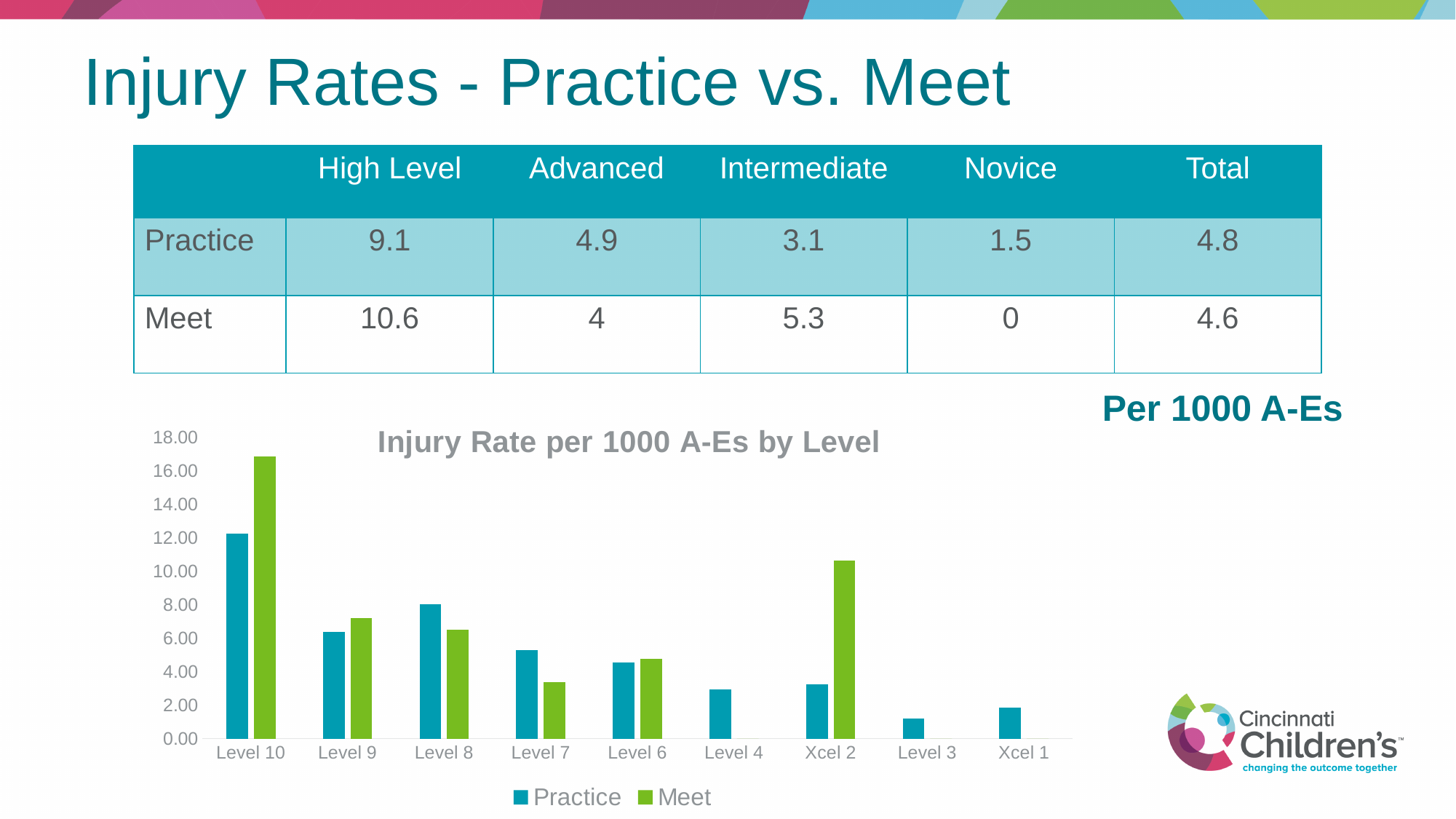
How many series does the chart legend list? 2 How many levels are shown along the x axis of the chart? 9 Is the Meet value for Level 10 greater or less than 14.00? greater Which level has the highest Practice injury rate in the chart? Level 10 What kind of chart is shown on the slide? bar chart What is the title of the chart? Injury Rate per 1000 A-Es by Level Is the Practice value for Level 10 greater or less than 10.00? greater For Level 7, which is larger: the Practice bar or the Meet bar? Practice Which level has the highest Meet injury rate in the chart? Level 10 For Xcel 2, which is larger: the Practice bar or the Meet bar? Meet For Level 8, which is larger: the Practice bar or the Meet bar? Practice Which level has the lowest Practice injury rate in the chart? Level 3